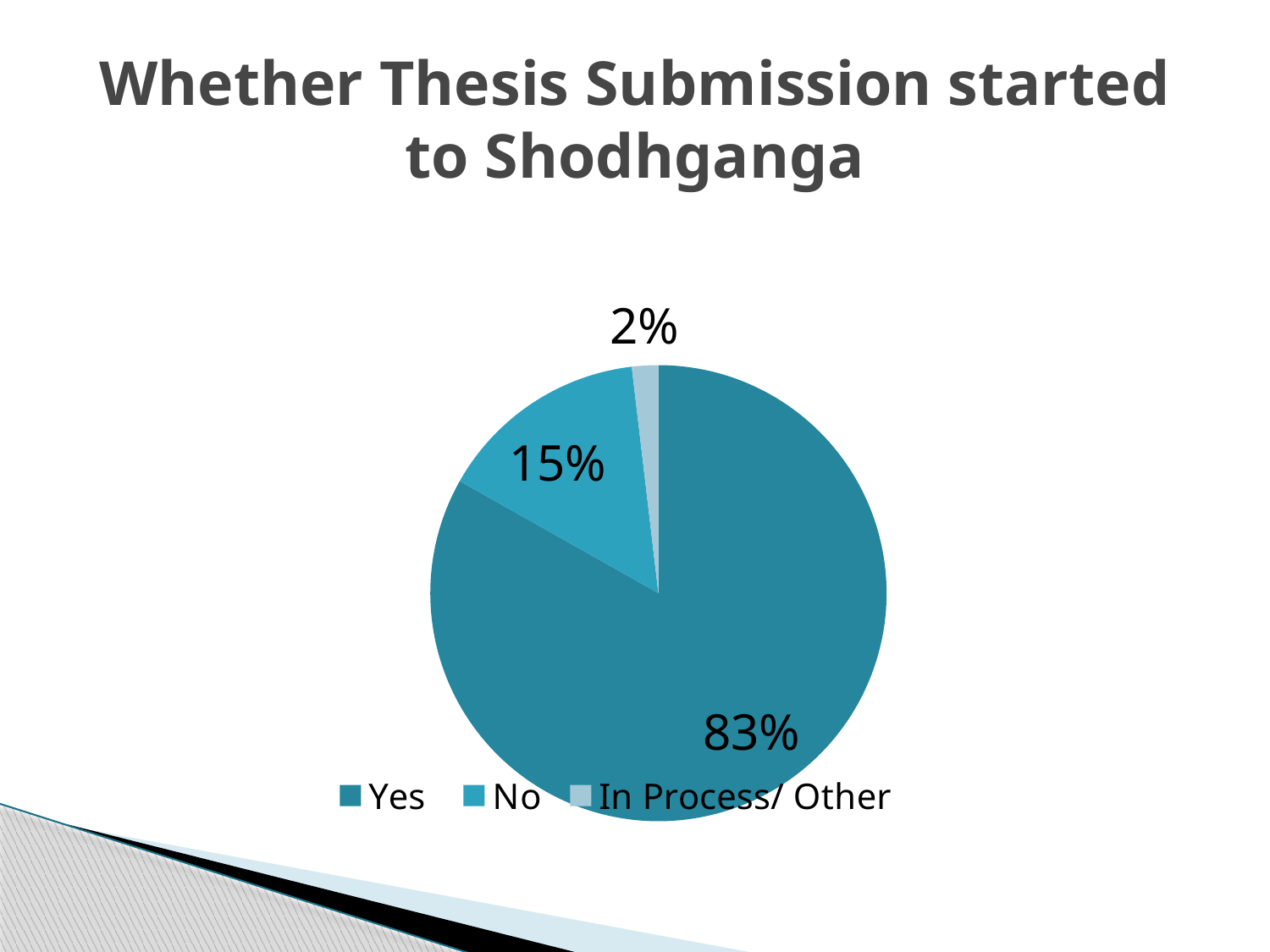
What percentage of the pie is labelled "In Process/ Other"? 2% What percentage of the pie is labelled "Yes"? 83% Which slice is larger, "No" or "In Process/ Other"? No Which category has the largest share of the pie? Yes What kind of chart is shown on the slide? pie chart How many slices does the pie chart have? 3 What percentage of the pie is labelled "No"? 15% Which category has the smallest share of the pie? In Process/ Other How many entries does the legend list? 3 What is the difference in percentage points between the "Yes" and "No" slices? 68 What is the combined share of the "No" and "In Process/ Other" slices? 17% What is the title of the slide? Whether Thesis Submission started to Shodhganga